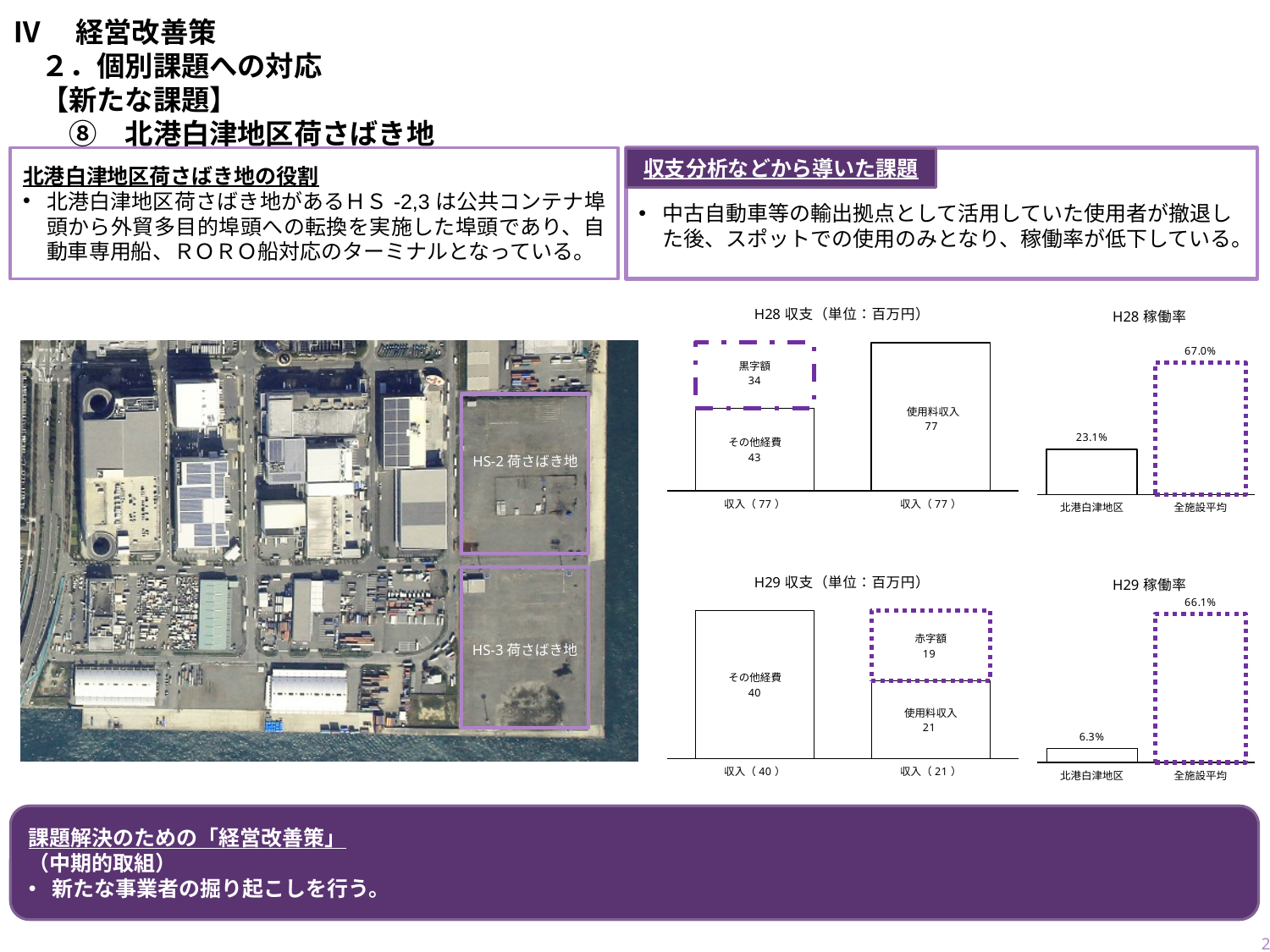
「H29 収支」のグラフで、赤字額はいくらですか？ 19 「H28 稼働率」のグラフで、全施設平均の稼働率はいくらですか？ 67.0% 「H29 収支」のグラフで、その他経費と使用料収入ではどちらが大きいですか？ その他経費 「H28 稼働率」のグラフで、北港白津地区の稼働率はいくらですか？ 23.1% 「H29 稼働率」のグラフで、全施設平均と北港白津地区の稼働率の差は何ポイントですか？ 59.8ポイント 「H29 収支」のグラフで、使用料収入と赤字額を合計するといくらになりますか？ 40 「H28 収支」のグラフで、その他経費の値はいくらですか？ 43 「H28 収支」のグラフで、使用料収入はいくらですか？ 77 「H29 稼働率」のグラフはどの種類のグラフですか？ 棒グラフ 「H28 収支」のグラフで、黒字額はいくらですか？ 34 「H29 稼働率」のグラフで、北港白津地区の稼働率はいくらですか？ 6.3% 「H28 稼働率」のグラフで、稼働率が高いのは北港白津地区と全施設平均のどちらですか？ 全施設平均